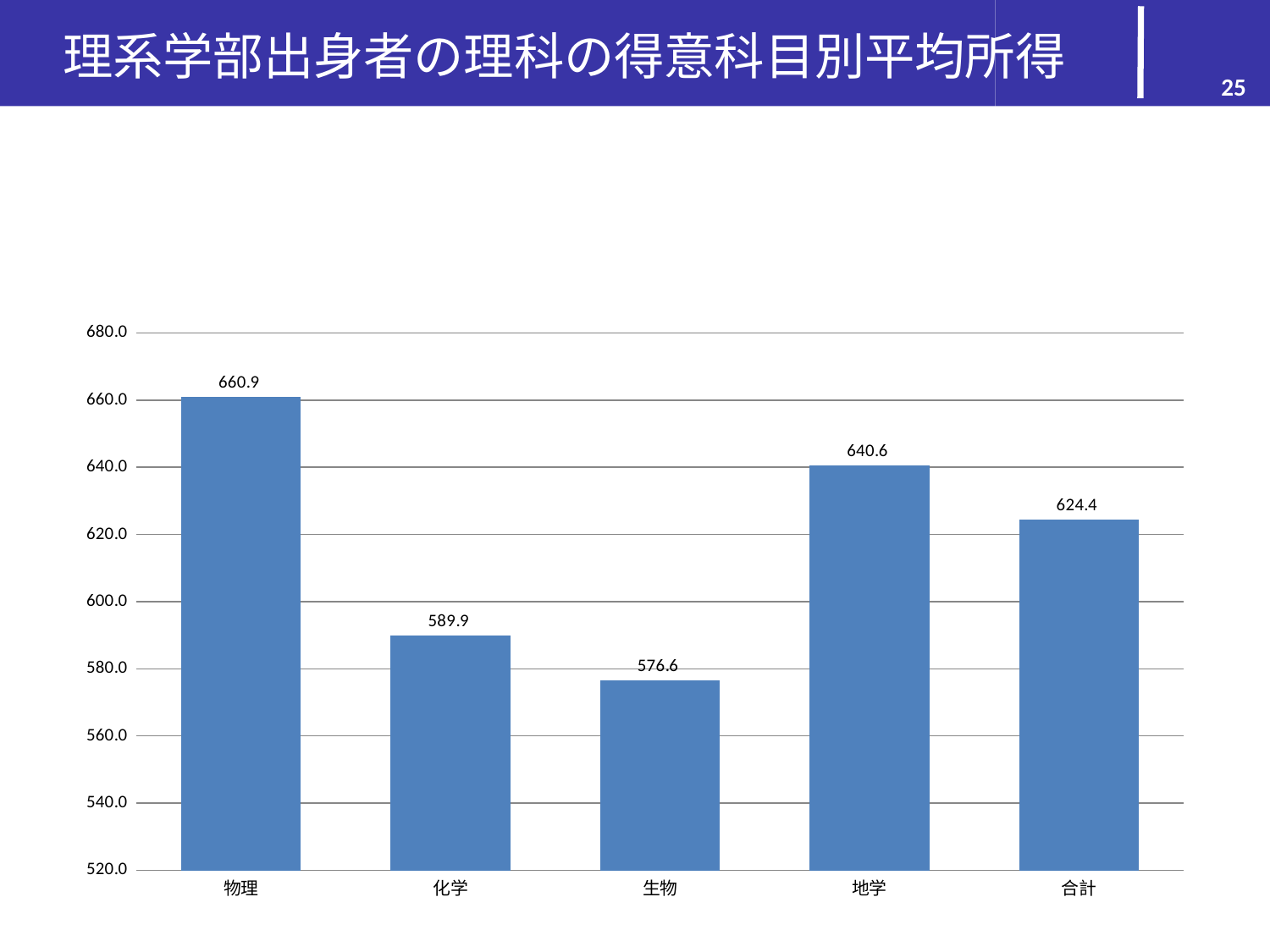
What is the value for 物理? 660.9 Is the value for 化学 greater or less than 600.0? less What is the value for 地学? 640.6 What is the value for 合計? 624.4 What is the difference between the values for 物理 and 生物? 84.3 Which category has the highest value? 物理 What kind of chart is shown on the slide? bar chart Which is larger, the value for 地学 or the value for 合計? 地学 What is the value for 化学? 589.9 How many categories are shown on the x axis? 5 What is the value for 生物? 576.6 Which category has the lowest value? 生物